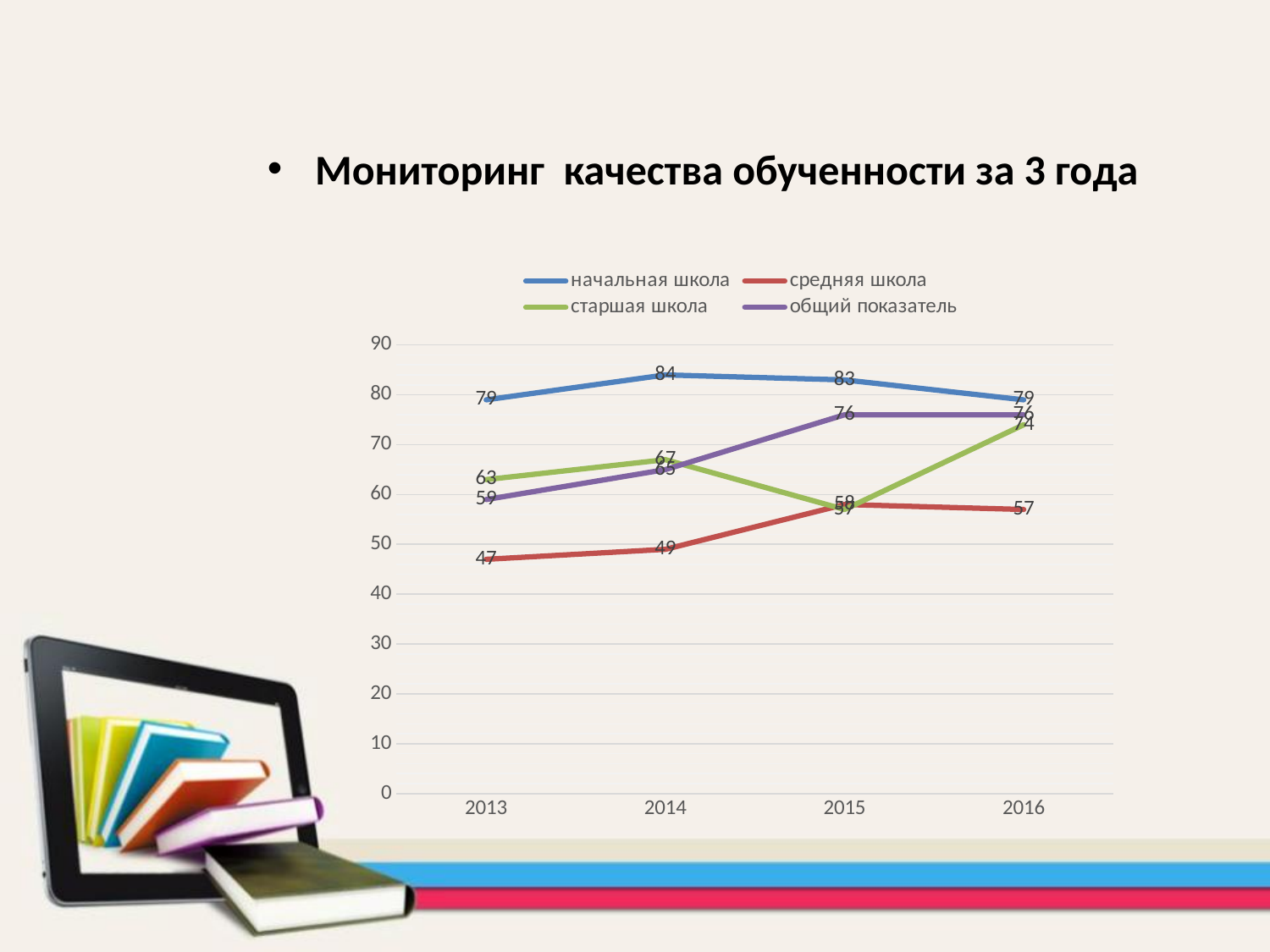
What type of chart is shown on the slide? line chart In which year is the value for средняя школа lowest? 2013 What is the value for общий показатель in 2016? 76 What is the difference between начальная школа and средняя школа in 2014? 35 In which year is the value for начальная школа highest? 2014 What is the value for старшая школа in 2016? 74 What is the value for начальная школа in 2014? 84 Which series has the larger value in 2013, старшая школа or общий показатель? старшая школа How many series does the legend list? 4 What is the value for средняя школа in 2013? 47 Does the value for общий показатель rise or fall from 2013 to 2015? rise How many years are shown on the x axis? 4